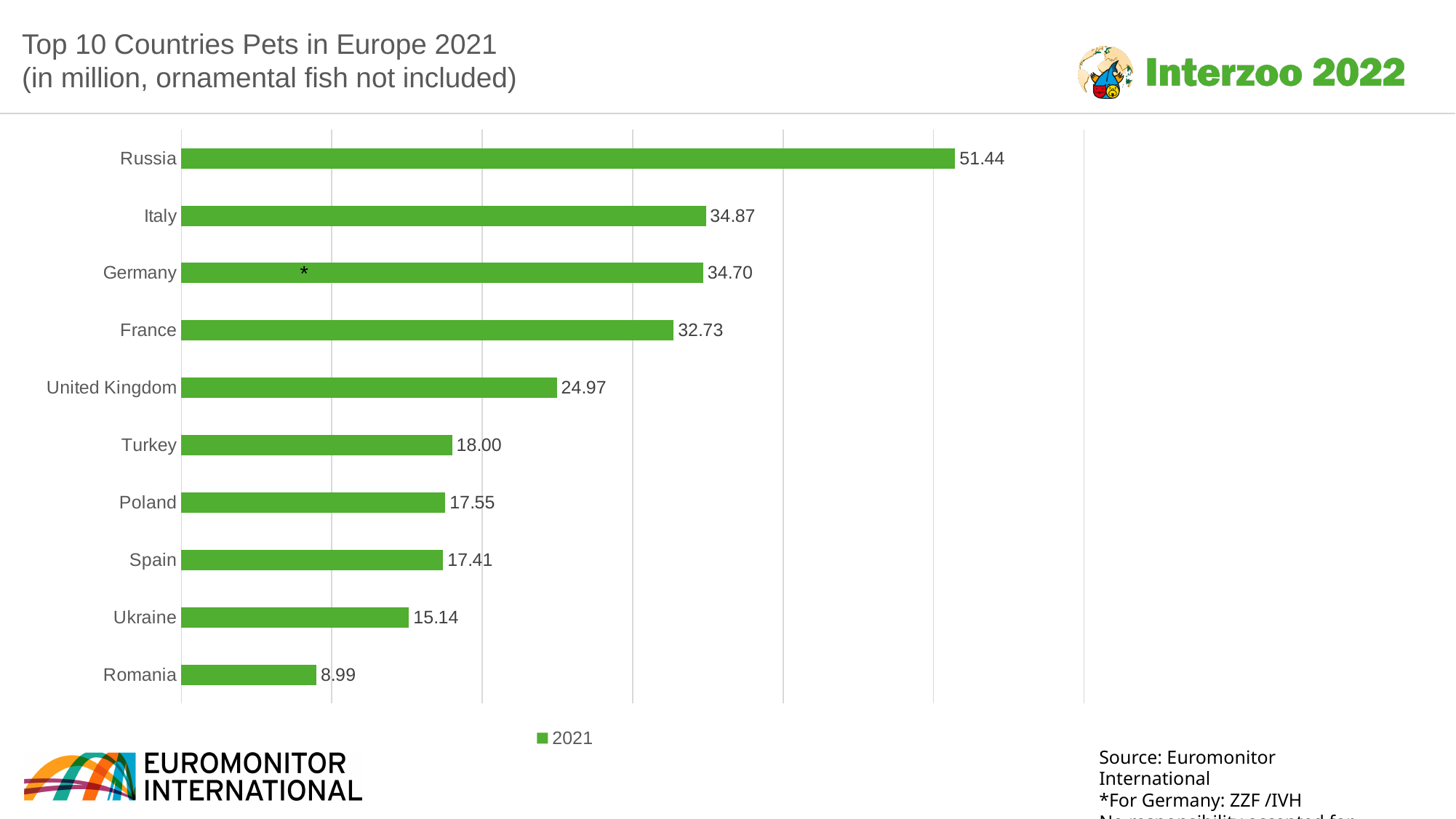
How many countries are shown in the chart? 10 Which has a larger value, France or the United Kingdom? France What is the difference between the values for Russia and Italy? 16.57 What is the value for the United Kingdom? 24.97 How many series does the legend list? 1 Which country has the lowest value? Romania What is the difference between the values for Turkey and Romania? 9.01 What series name is shown in the legend? 2021 What is the value for Russia? 51.44 Which country has the highest value? Russia What is the value for Romania? 8.99 What kind of chart is shown on the slide? Bar chart